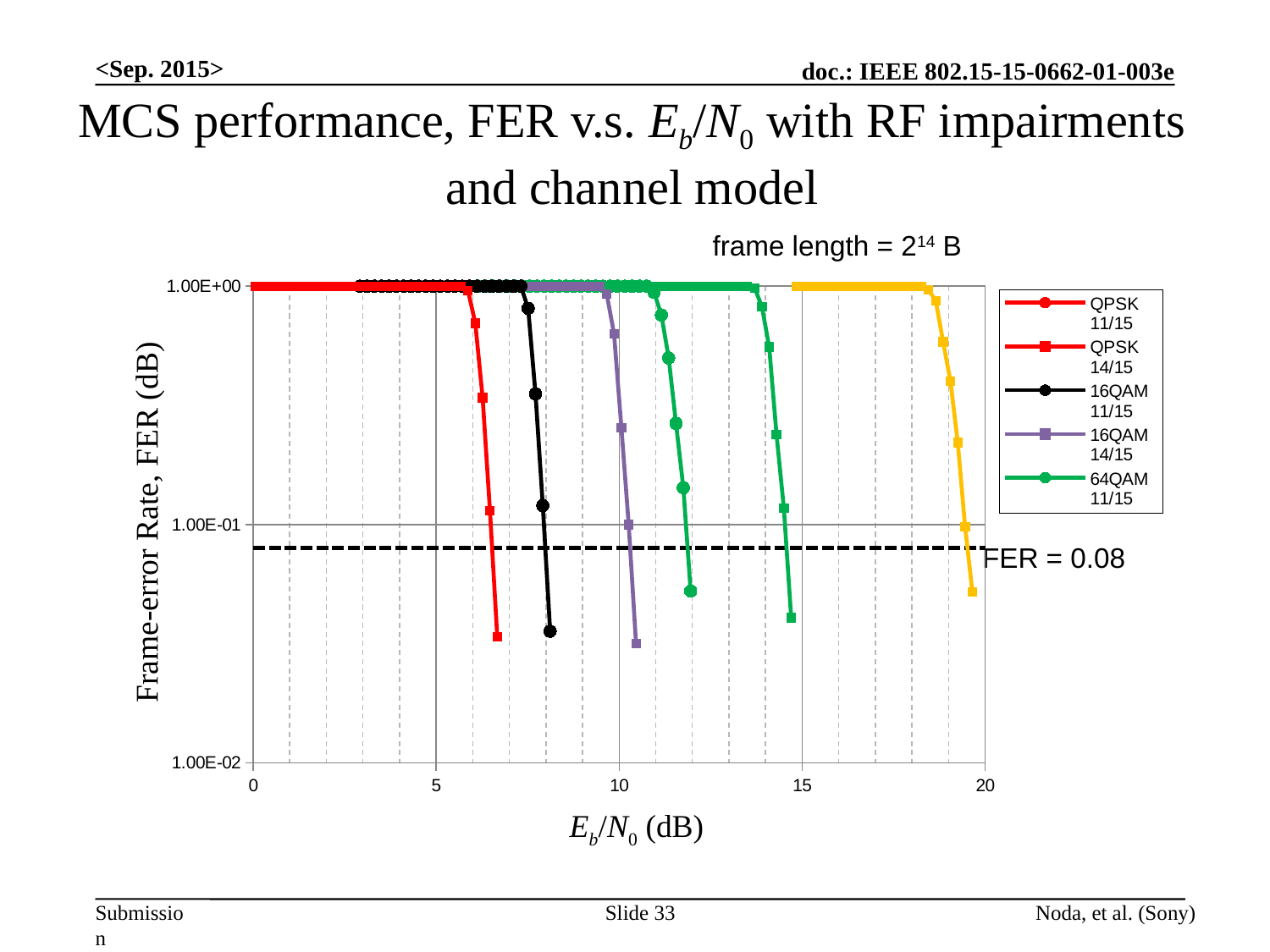
What kind of chart is shown on the slide? line chart Is the FER for QPSK 14/15 at Eb/N0 = 5 dB greater or less than 1.00E-01? greater Which series drops below the FER = 0.08 line at a higher Eb/N0: 16QAM 14/15 or 64QAM 11/15? 64QAM 11/15 How many series does the chart legend list? 5 How many labelled tick values are shown on the x axis? 5 What frame length is stated above the chart? 2^14 B What is the lowest labelled value on the y axis? 1.00E-02 Is the FER for 64QAM 11/15 at Eb/N0 = 10 dB greater or less than 1.00E-01? greater Which series drops below the FER = 0.08 line at a lower Eb/N0: QPSK 14/15 or 16QAM 11/15? QPSK 14/15 What FER value does the horizontal dashed line mark? FER = 0.08 As Eb/N0 increases along the x axis, does the frame-error rate for each series rise or fall? fall Is the FER for 16QAM 14/15 at Eb/N0 = 10 dB greater or less than 1.00E-02? greater